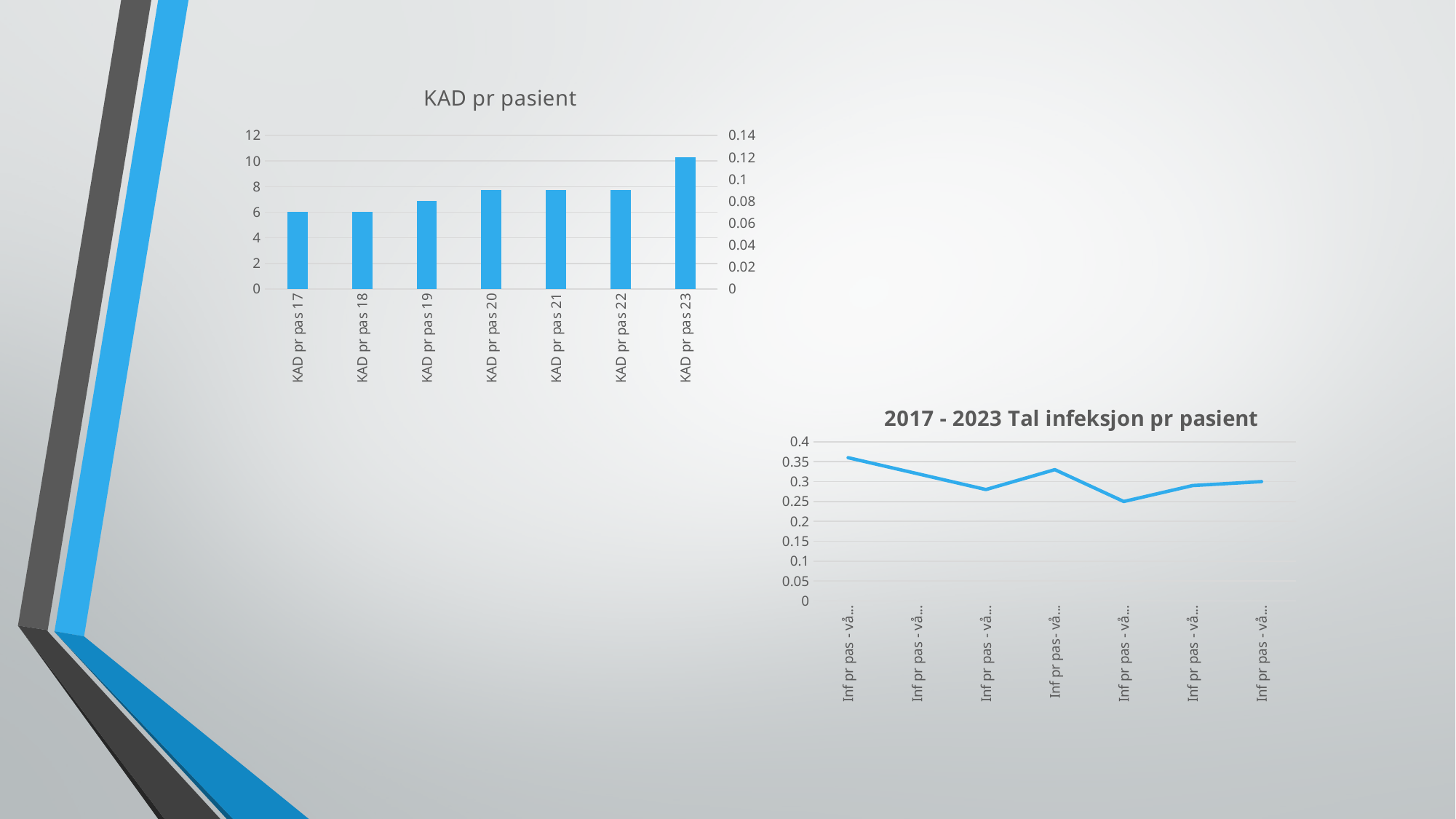
What kind of chart is the '2017 - 2023 Tal infeksjon pr pasient' chart? line chart In the '2017 - 2023 Tal infeksjon pr pasient' chart, is the fifth point on the line greater or less than 0.3? less In the 'KAD pr pasient' chart, how many bars are plotted? 7 What kind of chart is the 'KAD pr pasient' chart? bar chart In the 'KAD pr pasient' chart, which category has the highest bar? KAD pr pas 23 In the 'KAD pr pasient' chart, which is larger: the value for KAD pr pas 23 or KAD pr pas 19? KAD pr pas 23 In the 'KAD pr pasient' chart, is the value for KAD pr pas 17 greater or less than 8? less In the '2017 - 2023 Tal infeksjon pr pasient' chart, is the first point on the line greater or less than 0.3? greater In the '2017 - 2023 Tal infeksjon pr pasient' chart, how many data points are plotted on the line? 7 What is the title of the line chart on the slide? 2017 - 2023 Tal infeksjon pr pasient